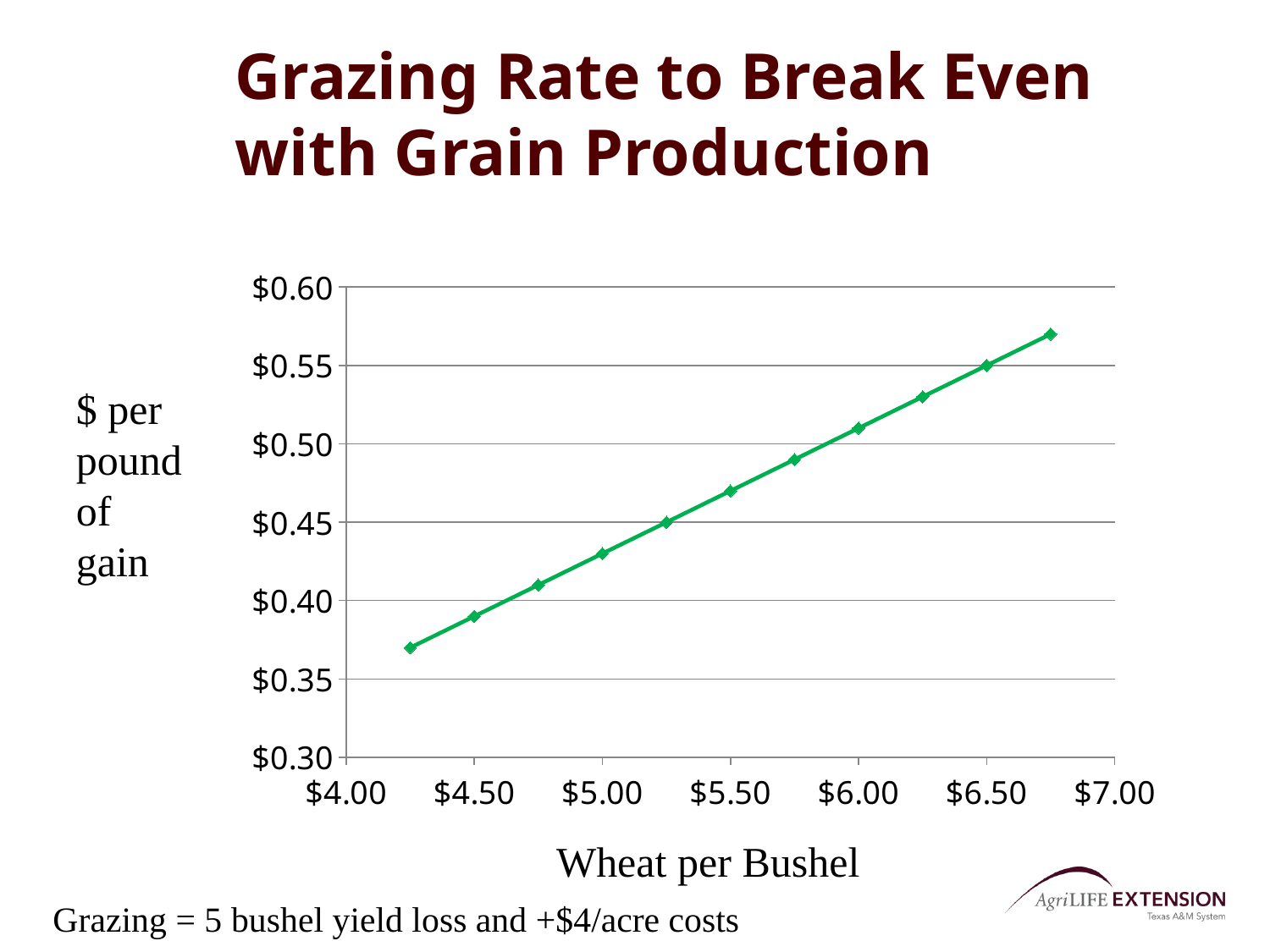
Is the value at $5.00 per bushel greater or less than $0.45? less What is the label of the x axis? Wheat per Bushel What kind of chart is shown on the slide? line chart How many data points are plotted on the line? 11 Is the value at $6.00 per bushel greater or less than $0.55? less What is the value in $ per pound of gain when wheat is $6.50 per bushel? $0.55 Does the $ per pound of gain rise or fall as the wheat price per bushel increases? rises What is the title of the chart? Grazing Rate to Break Even with Grain Production Is the value at $4.50 per bushel greater or less than $0.35? greater Which is larger, the value at $6.50 per bushel or the value at $4.50 per bushel? $6.50 per bushel